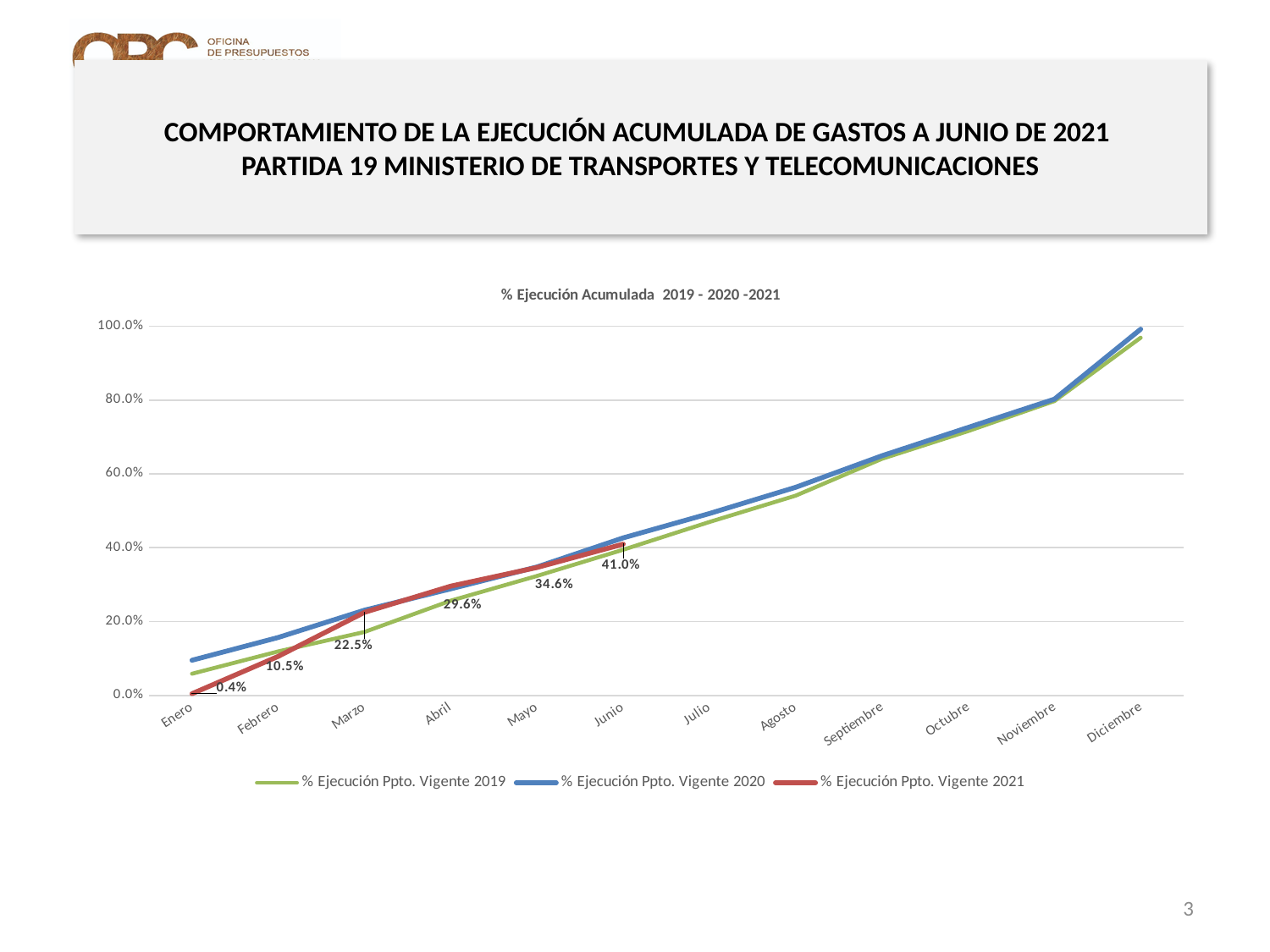
Do the values of the % Ejecución Ppto. Vigente 2020 series rise or fall from Enero to Diciembre? Rise What is the value of % Ejecución Ppto. Vigente 2021 for Abril? 29.6% How many series does the legend list? 3 In which month is the % Ejecución Ppto. Vigente 2021 series lowest? Enero What is the value of % Ejecución Ppto. Vigente 2021 for Junio? 41.0% What is the value of % Ejecución Ppto. Vigente 2021 for Enero? 0.4% What kind of chart is shown on the slide? Line chart What is the value of % Ejecución Ppto. Vigente 2021 for Marzo? 22.5% By how many percentage points does the 2021 series increase from Mayo to Junio? 6.4 In which month does the % Ejecución Ppto. Vigente 2021 series reach its highest value? Junio Is the value of % Ejecución Ppto. Vigente 2020 for Diciembre greater or less than 80.0%? greater Is the value of % Ejecución Ppto. Vigente 2019 for Enero greater or less than 20.0%? less